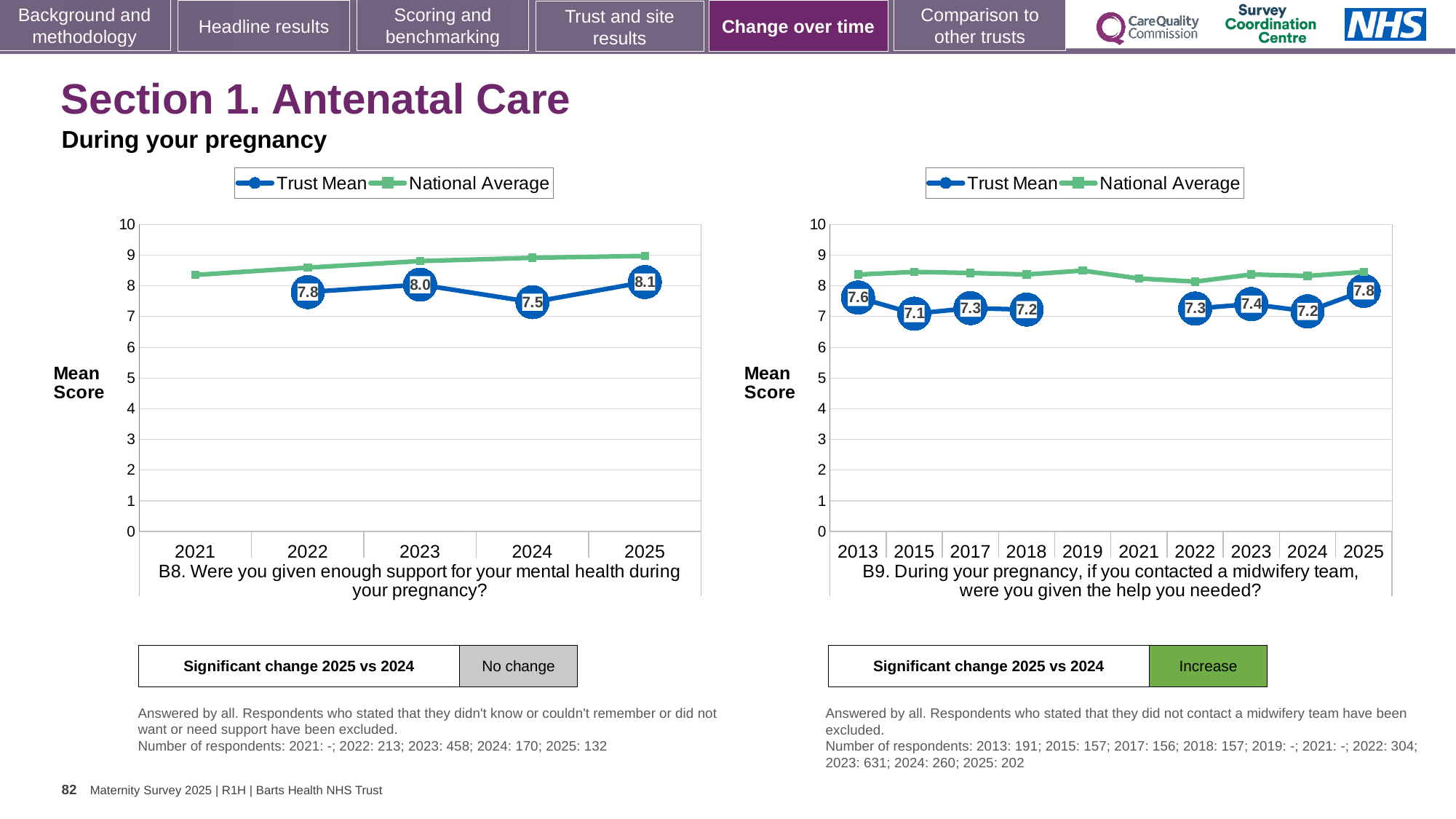
How many series does the legend of the left chart (B8) list? 2 In the left chart (B8), what is the Trust Mean for 2024? 7.5 How many years are shown on the x axis of the right chart (B9)? 10 In the left chart (B8), is the National Average for 2025 greater or less than 8? greater In the right chart (B9), what is the Trust Mean for 2013? 7.6 In the left chart (B8), what is the Trust Mean for 2025? 8.1 In the right chart (B9), which year has the highest labelled Trust Mean? 2025 In the left chart (B8), what is the difference between the Trust Mean in 2025 and in 2024? 0.6 In the left chart (B8), which year has the lowest labelled Trust Mean? 2024 In the right chart (B9), which year has the lowest labelled Trust Mean? 2015 What kind of chart is the right chart (B9)? Line chart In the right chart (B9), is the Trust Mean larger in 2023 or in 2024? 2023